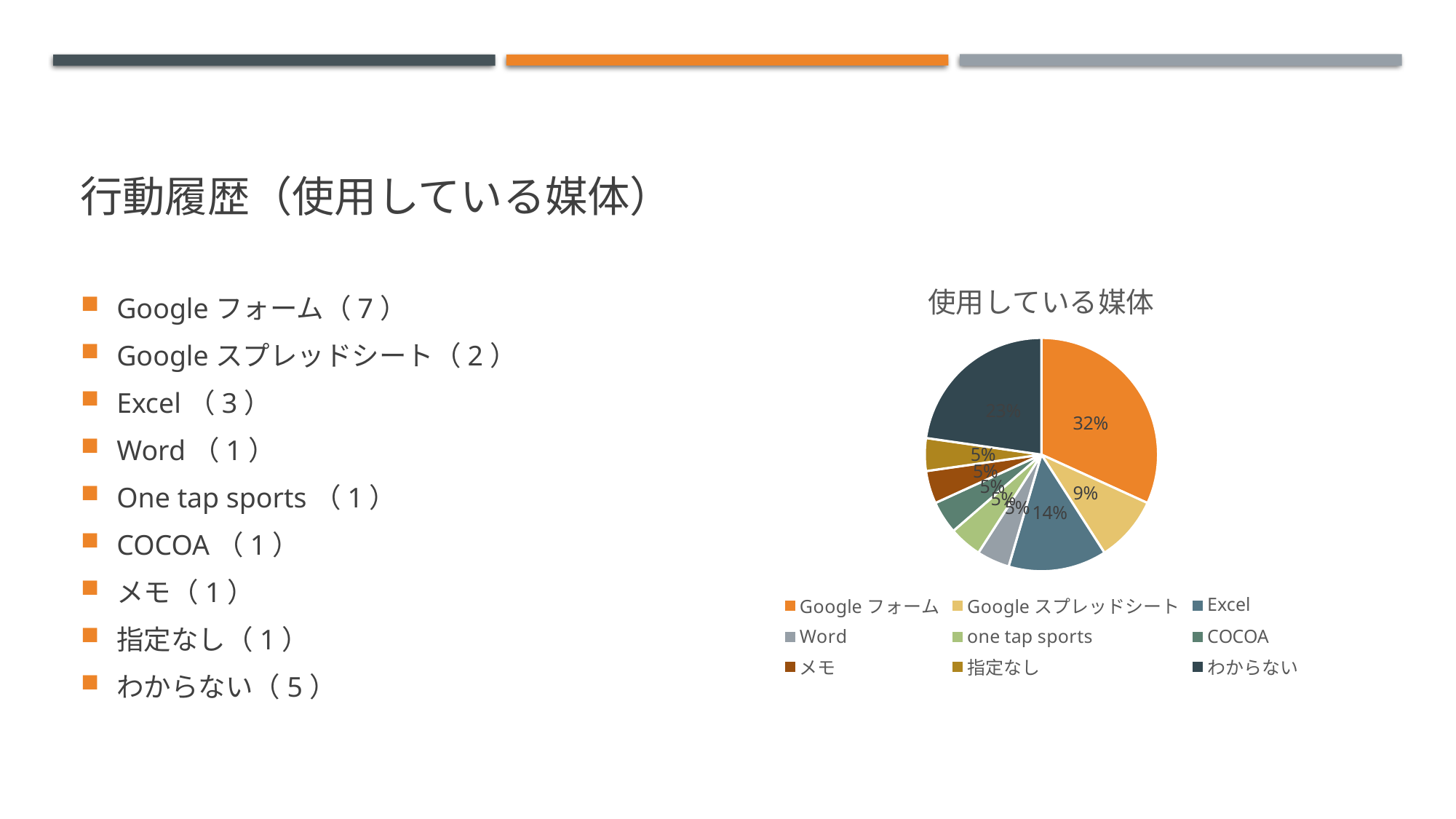
What percentage of the pie does Google スプレッドシート account for? 9% What colour is the Google フォーム slice? orange What percentage of the pie does Google フォーム account for? 32% Which is larger, the slice for Excel or the slice for Google スプレッドシート? Excel What percentage of the pie does Word account for? 5% What is the difference in percentage points between the Google フォーム slice and the Excel slice? 18 What type of chart is shown on the slide? pie chart Which is larger, the slice for Google フォーム or the slice for Excel? Google フォーム What percentage of the pie does Excel account for? 14% How many categories does the legend list? 9 Which category has the largest slice of the pie? Google フォーム What is the title of the chart? 使用している媒体